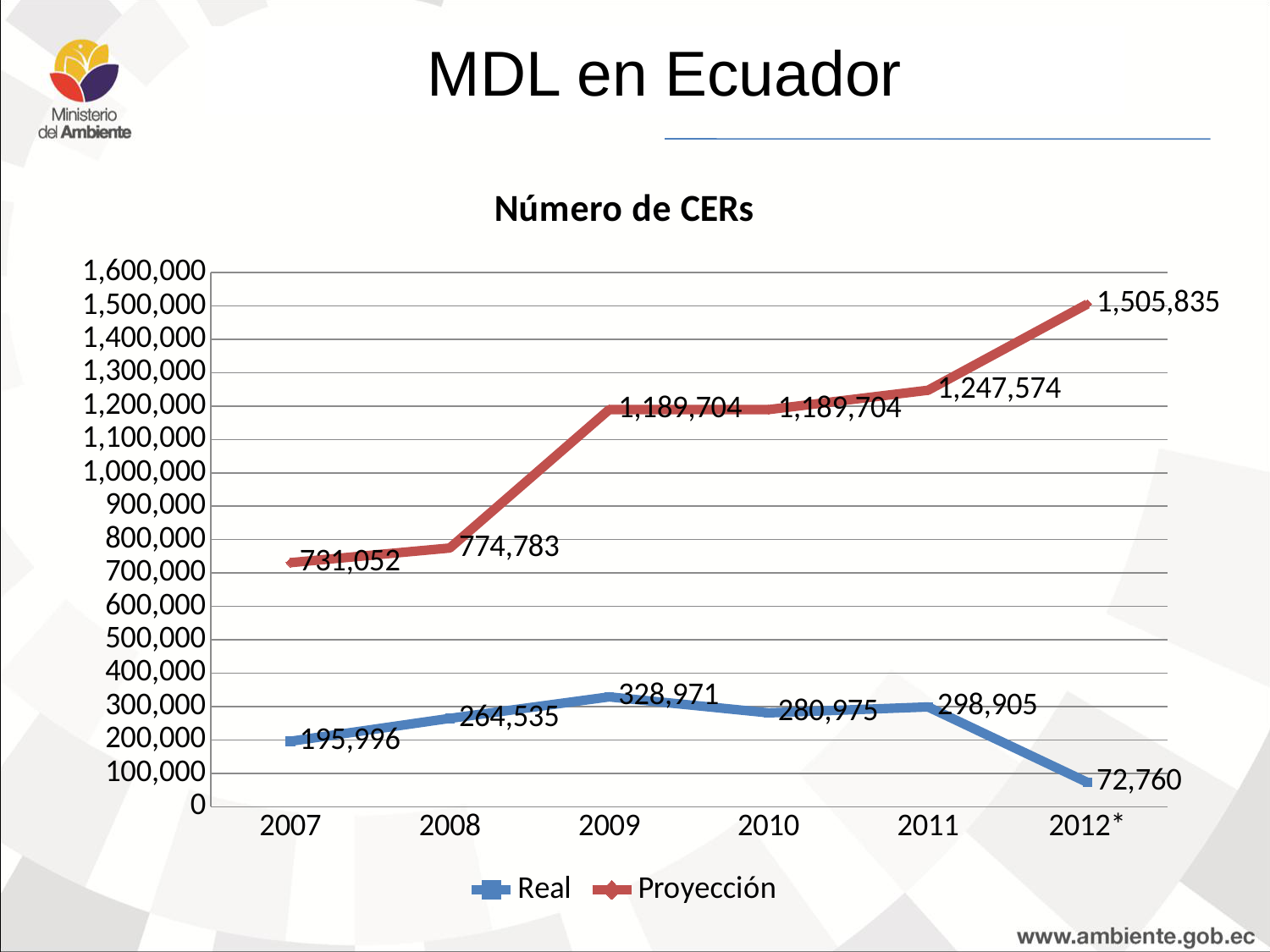
What is the value of the Real series in 2009? 328,971 Which is larger, the Real value in 2010 or the Real value in 2011? 2011 In which year is the Real series at its highest? 2009 How many series does the legend list? 2 What is the difference between the Proyección and Real values in 2012*? 1,433,075 Does the Proyección series rise or fall from 2007 to 2012*? rise What is the value of the Real series in 2007? 195,996 How many years are shown on the x axis? 6 What kind of chart is shown? line chart In which year is the Real series at its lowest? 2012* What is the value of the Proyección series in 2012*? 1,505,835 Is the Proyección value for 2008 greater or less than 800,000? less